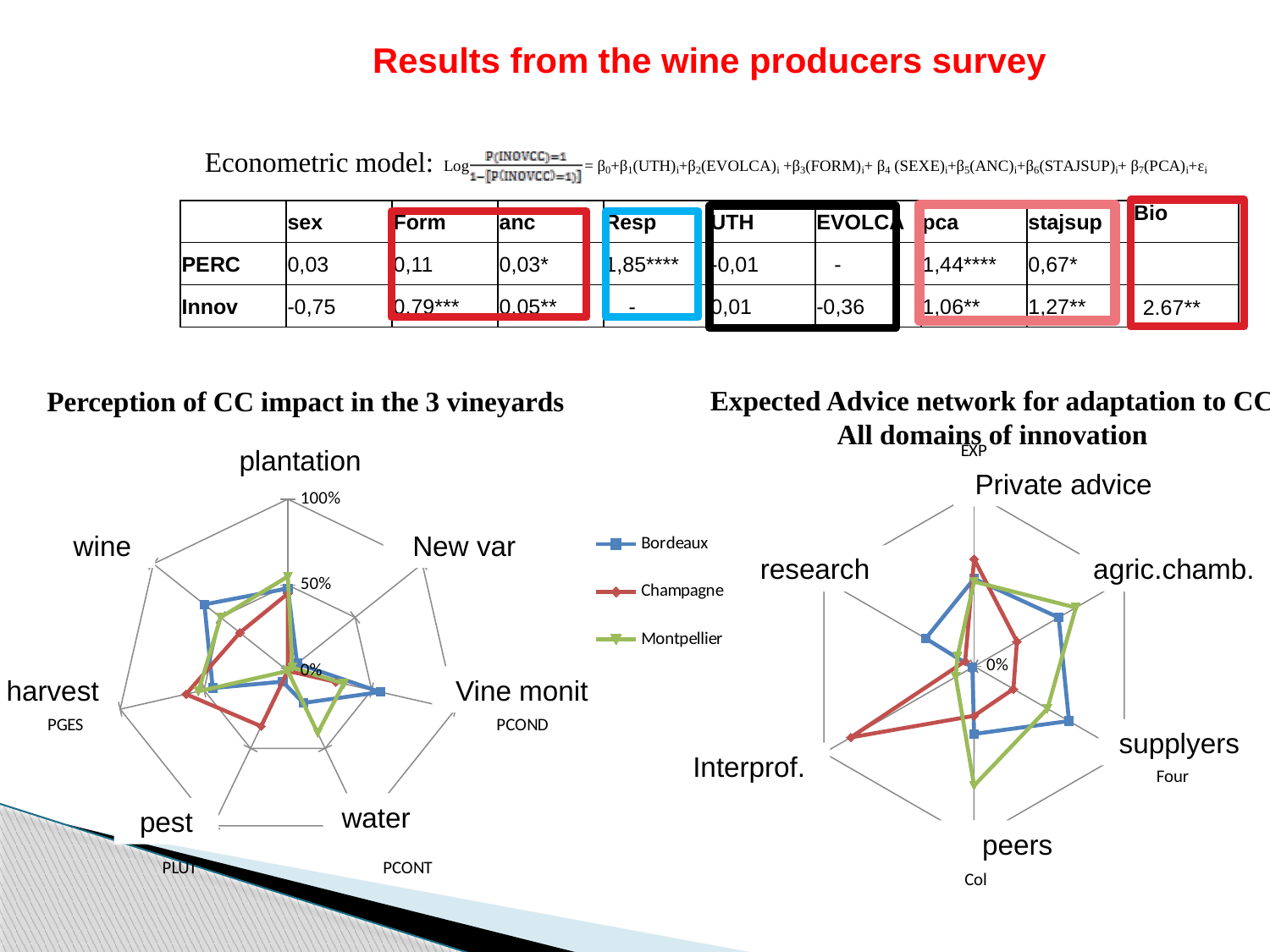
How many series does the legend list for the radar charts? 3 In the 'Perception of CC impact in the 3 vineyards' chart, which series has the highest value for Vine monit? Bordeaux In the 'Perception of CC impact in the 3 vineyards' chart, is the value for Champagne at pest greater or less than 50%? less In the 'Expected Advice network for adaptation to CC' chart, which series has the highest value for peers? Montpellier What kind of chart is the 'Perception of CC impact in the 3 vineyards' chart? Radar chart Which series are listed in the legend of the radar charts? Bordeaux, Champagne, Montpellier How many categories (axes) does the 'Expected Advice network for adaptation to CC' chart have? 6 In the 'Expected Advice network for adaptation to CC' chart, which is larger for research: Bordeaux or Champagne? Bordeaux How many categories (axes) does the 'Perception of CC impact in the 3 vineyards' chart have? 7 In the 'Expected Advice network for adaptation to CC' chart, which series has the highest value for Interprof.? Champagne